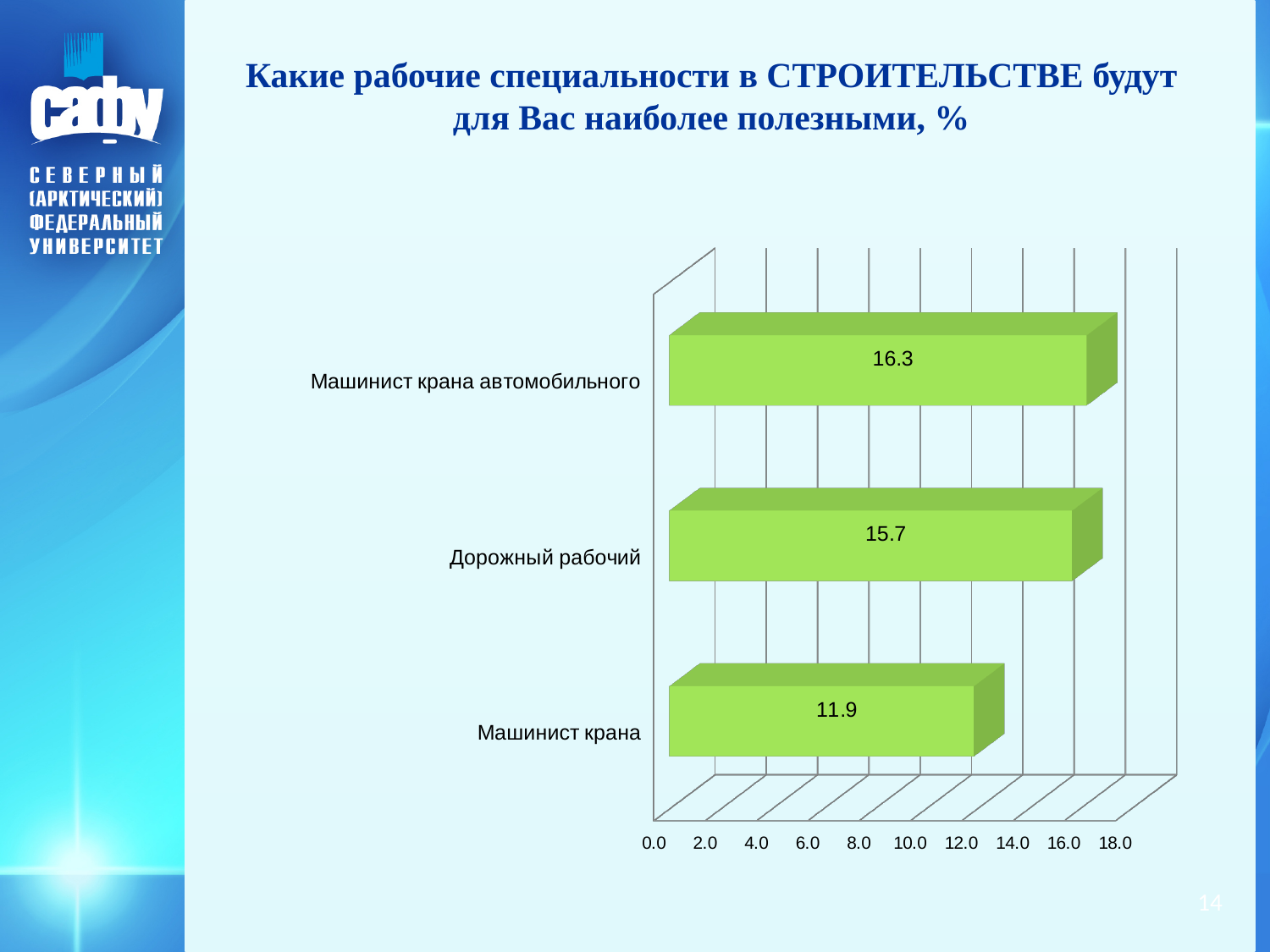
Which is larger, the value for Дорожный рабочий or the value for Машинист крана? Дорожный рабочий What is the maximum value shown on the horizontal axis? 18.0 What is the value for Машинист крана автомобильного? 16.3 What is the difference between the values for Машинист крана автомобильного and Машинист крана? 4.4 How many categories are shown in the chart? 3 What is the value for Машинист крана? 11.9 Which category has the highest value? Машинист крана автомобильного What is the value for Дорожный рабочий? 15.7 What is the difference between the values for Дорожный рабочий and Машинист крана? 3.8 Is the value for Машинист крана greater or less than 14.0? less Which category has the lowest value? Машинист крана What kind of chart is shown on the slide? bar chart